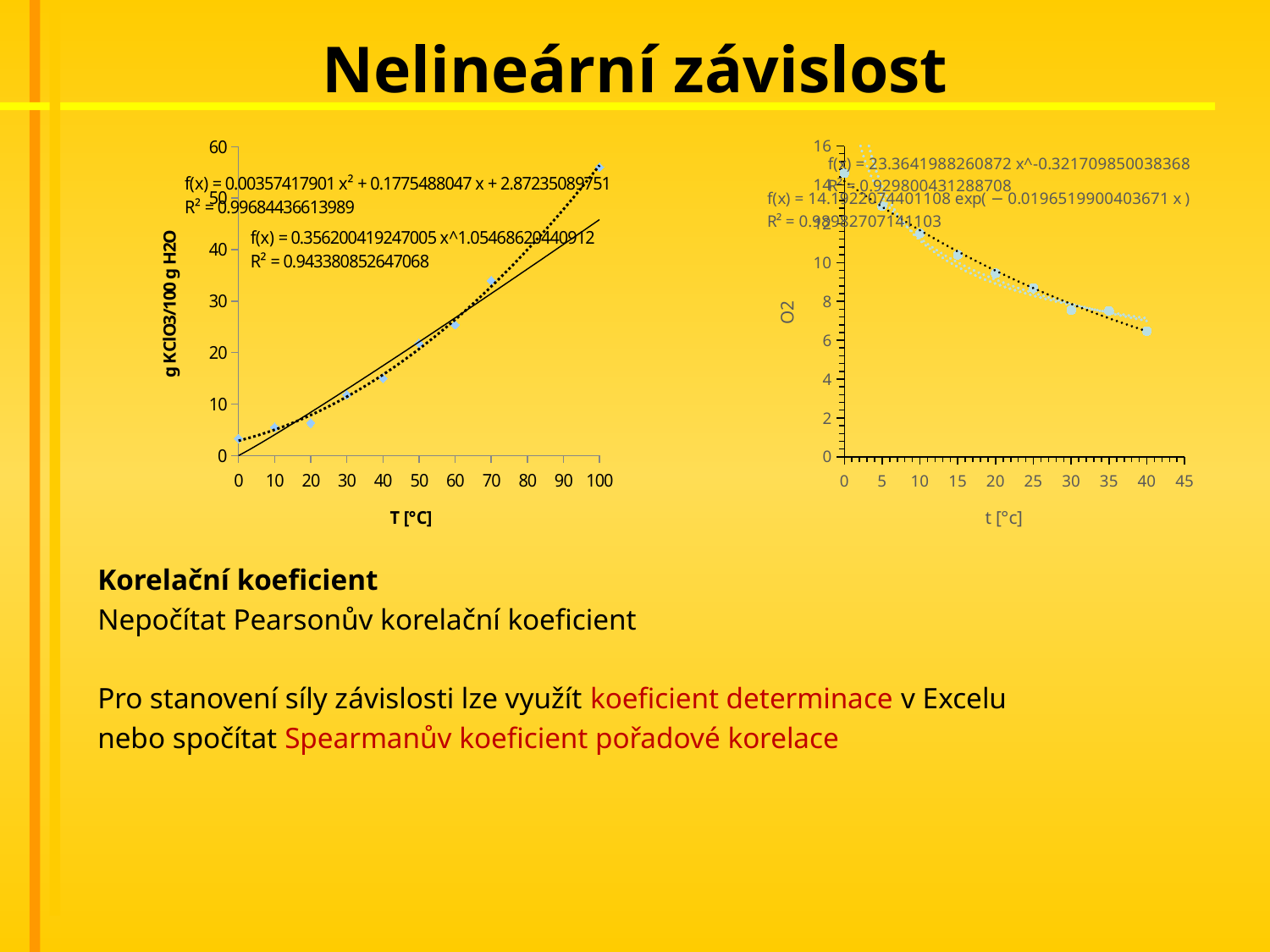
What kind of chart is the left chart (g KClO3/100 g H2O vs T [°C])? scatter chart What is the x-axis title of the left chart? T [°C] What is the y-axis title of the right chart? O2 In the left chart (g KClO3/100 g H2O vs T [°C]), is the value at T = 100 greater or less than 50? greater In the left chart (g KClO3/100 g H2O vs T [°C]), do the plotted values rise or fall as T increases? rise In the left chart (g KClO3/100 g H2O vs T [°C]), is the value at T = 70 greater or less than 30? greater In the right chart (O2 vs t [°c]), is the value at t = 10 greater or less than 10? greater In the right chart (O2 vs t [°c]), which is larger, the value at t = 0 or the value at t = 40? t = 0 In the right chart (O2 vs t [°c]), do the plotted values rise or fall as t increases? fall In the right chart (O2 vs t [°c]), how many data points are plotted? 9